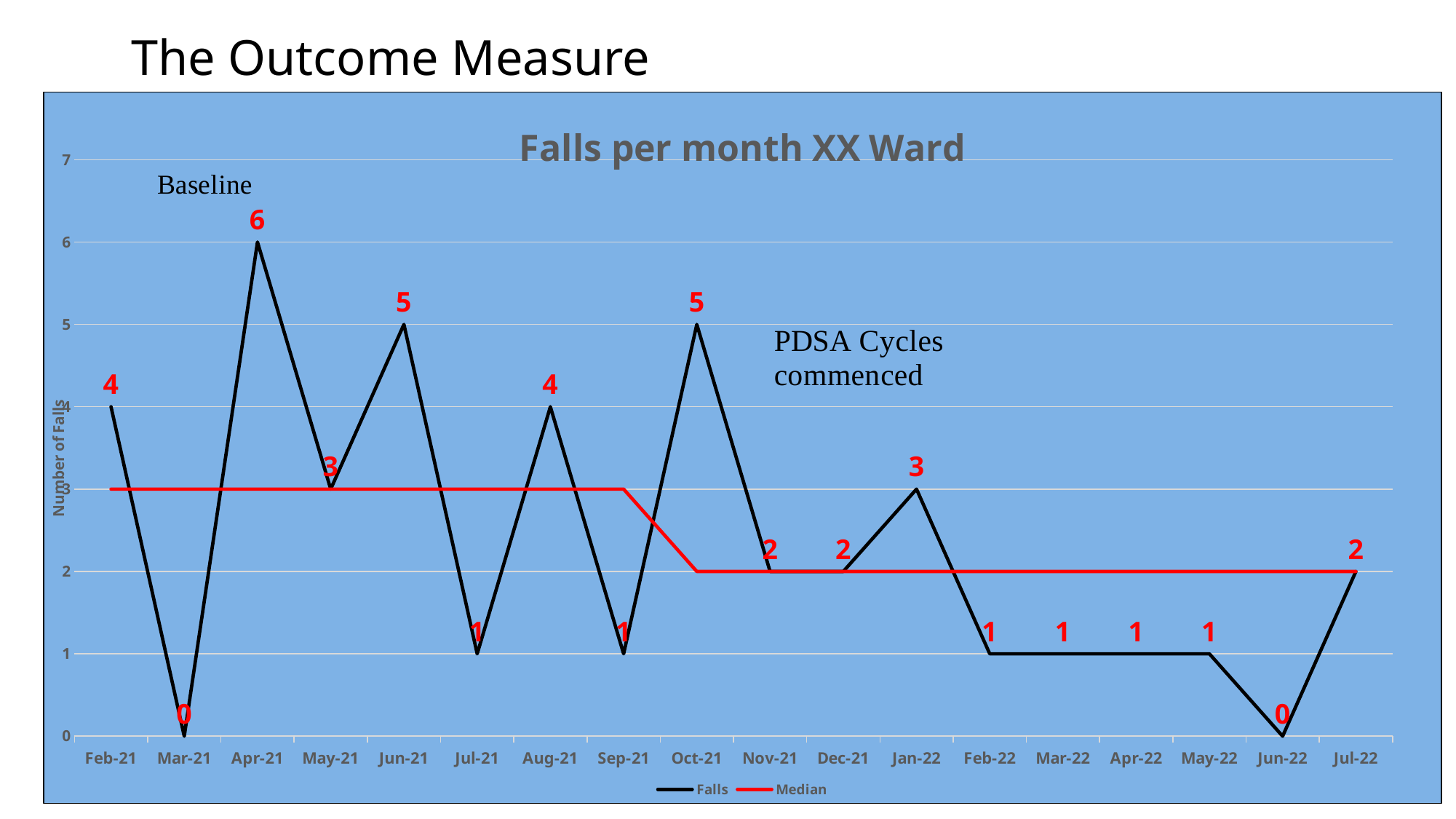
Which month has the highest number of falls? Apr-21 Do the falls values generally rise or fall from Feb-22 to Jun-22? Fall What is the number of falls in Apr-21? 6 How many months are plotted on the x axis? 18 Is the Median value for Feb-21 greater or less than 2? greater What is the title of the chart? Falls per month XX Ward What is the number of falls in Oct-21? 5 What is the number of falls in Jul-22? 2 What kind of chart is shown on the slide? Line chart What is the difference in falls between Apr-21 and May-21? 3 Which month has more falls, Jun-21 or Jan-22? Jun-21 How many series does the legend list? 2